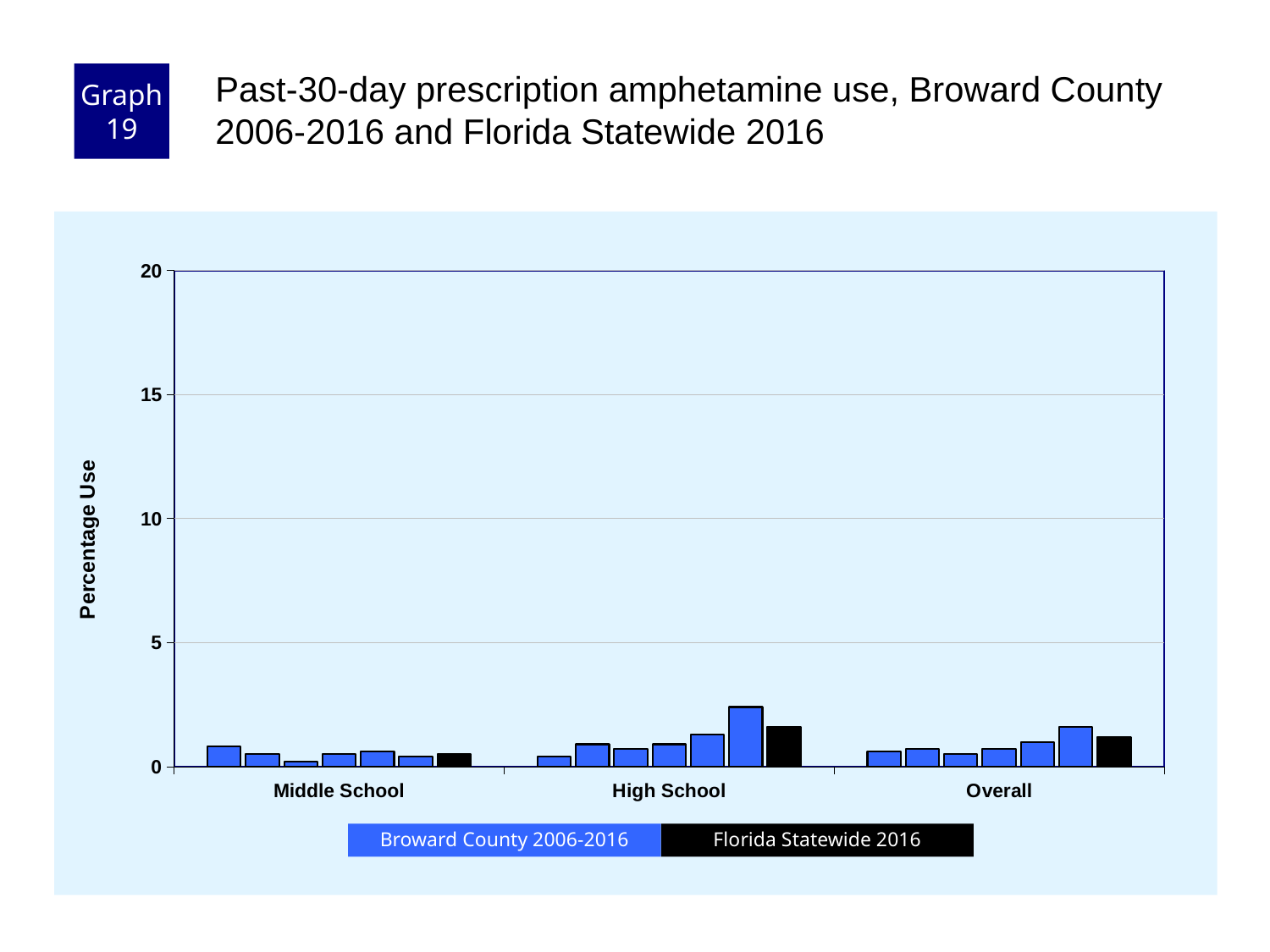
What kind of chart is shown on the slide? bar chart Which is larger: the Florida Statewide 2016 value for High School or the Florida Statewide 2016 value for Middle School? High School What is the label of the y axis? Percentage Use Which category contains the tallest bar on the chart? High School Is the value for Florida Statewide 2016 in the High School category greater or less than 5? less How many series does the legend list? 2 Which category has the lowest Florida Statewide 2016 value? Middle School Is the value for Florida Statewide 2016 in the Overall category greater or less than 10? less In the High School category, which is larger: the tallest Broward County 2006-2016 bar or the Florida Statewide 2016 bar? the tallest Broward County 2006-2016 bar Which colour represents Florida Statewide 2016 in the legend? black Is the tallest Broward County 2006-2016 bar in the High School category greater or less than 5? less How many school-level categories are shown on the x axis? 3